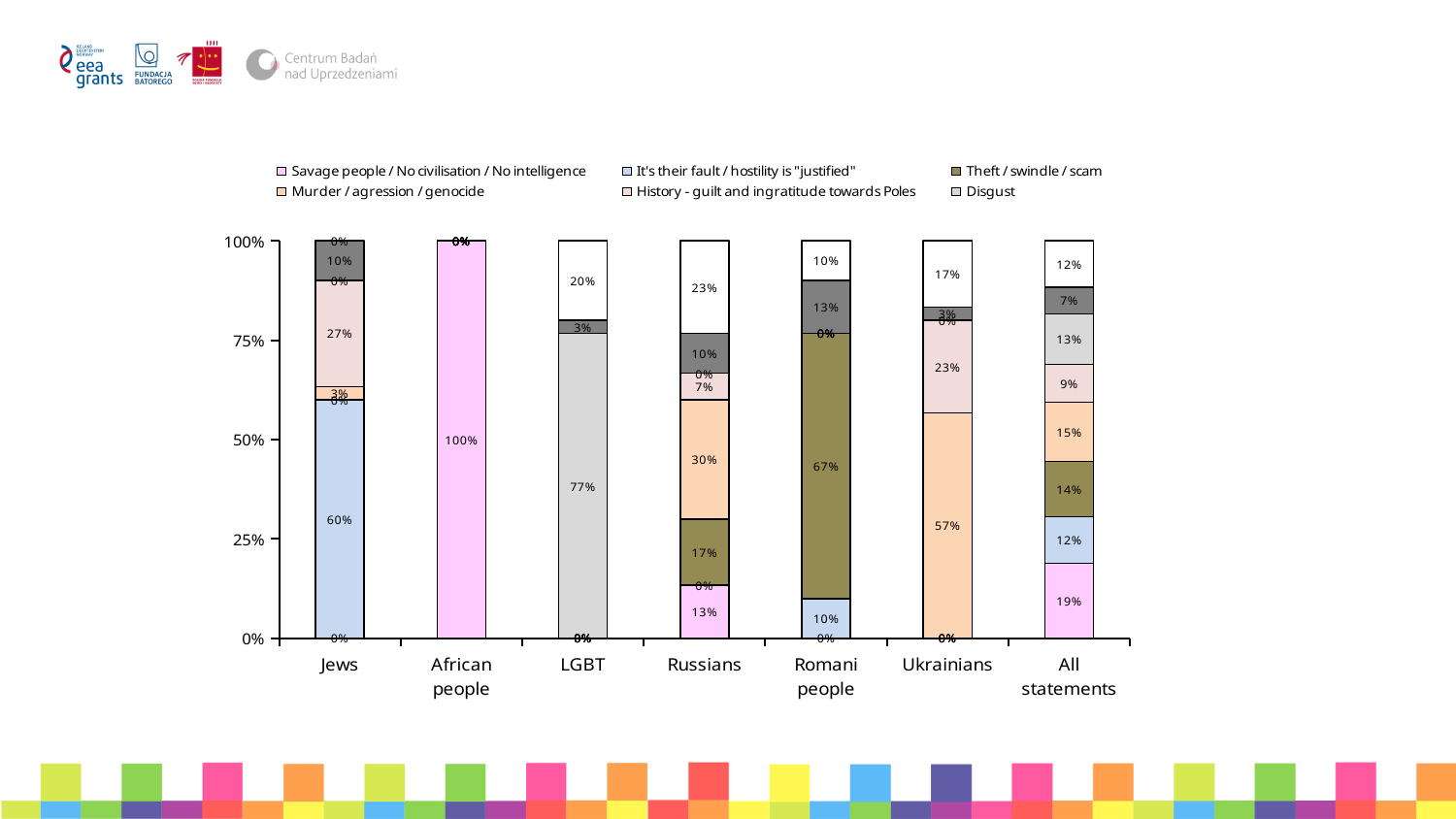
What kind of chart is shown on the slide? Stacked bar chart What is the value of the 'Savage people / No civilisation / No intelligence' segment for All statements? 19% How many categories are shown along the x axis of the chart? 7 What is the value of the 'Savage people / No civilisation / No intelligence' segment for African people? 100% What is the value of the 'Theft / swindle / scam' segment for Romani people? 67% How many series does the chart's legend list? 6 What is the difference between the 'Murder / agression / genocide' segment for Ukrainians (57%) and for Russians (30%)? 27 percentage points What is the value of the 'It's their fault / hostility is "justified"' segment for Jews? 60% Which category has the largest single segment in the chart? African people Which is larger: the 'Theft / swindle / scam' segment for Romani people or for Russians? Romani people What is the value of the 'Disgust' segment for Romani people? 0% What is the value of the 'Murder / agression / genocide' segment for Ukrainians? 57%